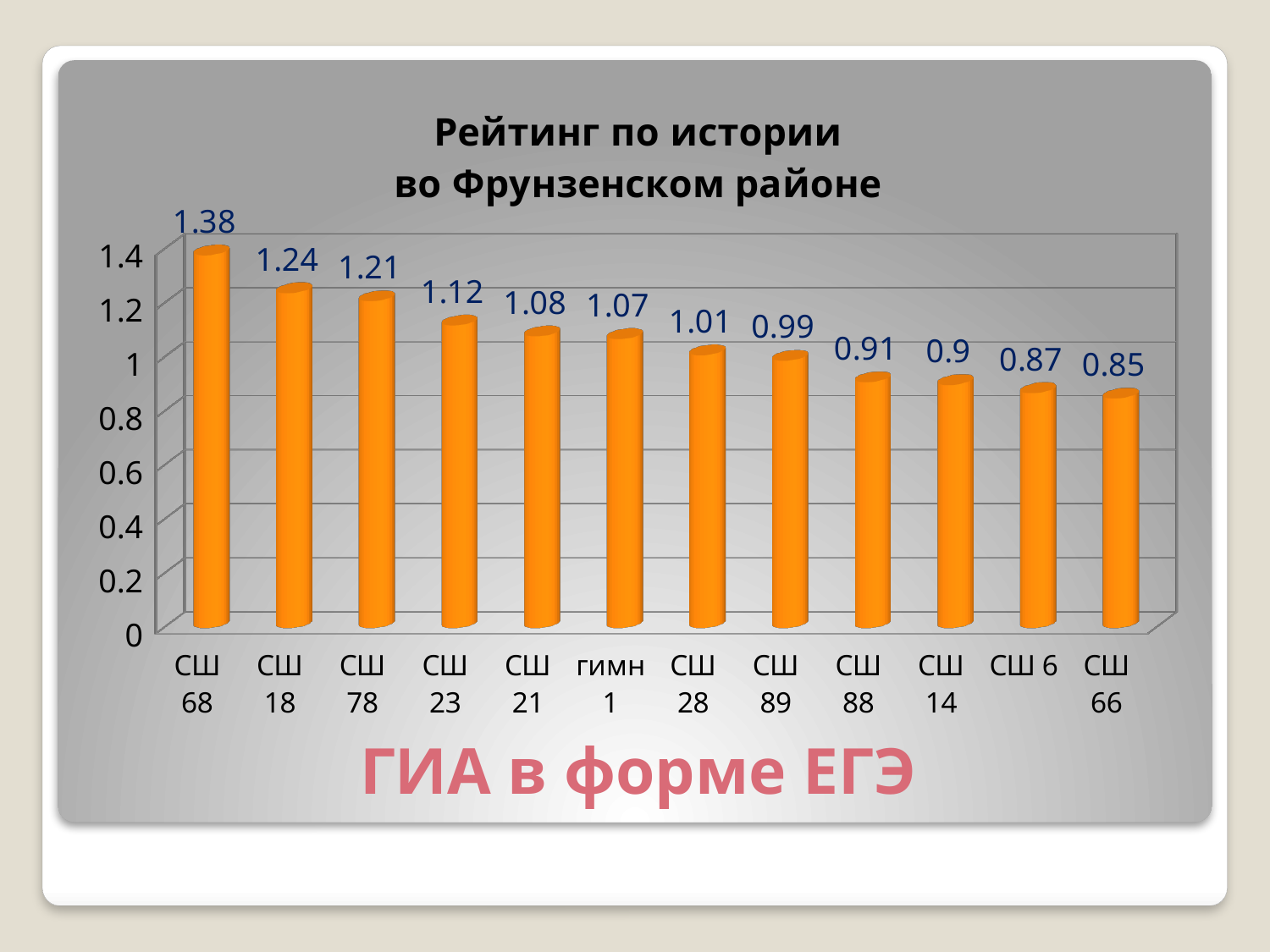
Is the value for СШ 89 greater or less than 1? less What is the difference between the values for СШ 68 and СШ 66? 0.53 What is the value for СШ 14? 0.9 What is the difference between the values for СШ 18 and СШ 78? 0.03 Which category has the highest value? СШ 68 What is the value for гимн 1? 1.07 What is the value for СШ 68? 1.38 Which is larger, the value for СШ 23 or the value for СШ 28? СШ 23 How many categories are shown on the chart? 12 What kind of chart is shown on the slide? bar chart Which category has the lowest value? СШ 66 Do the values rise or fall from left to right along the x axis? fall